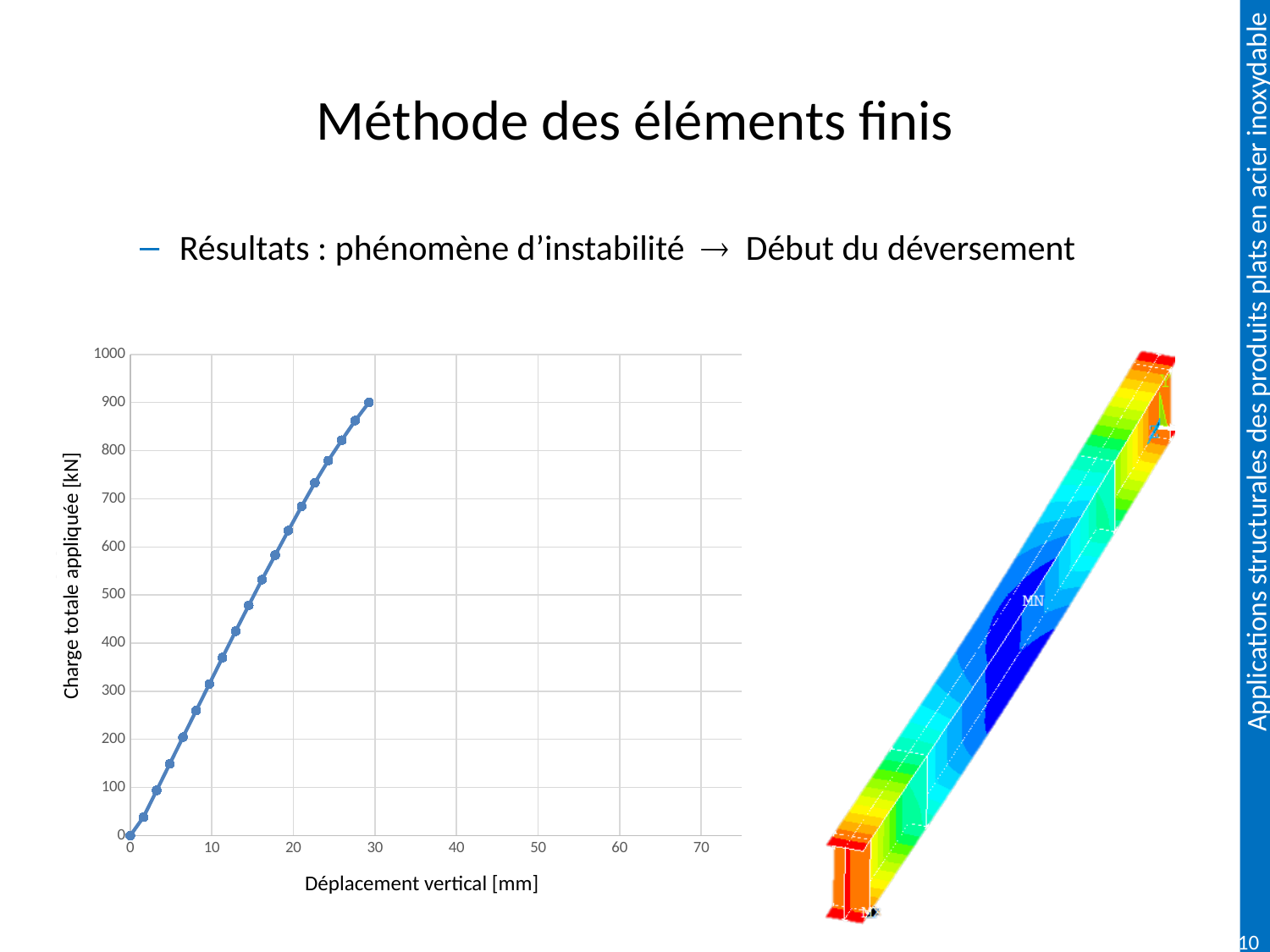
Is the highest applied load reached on the curve greater or less than 800 kN? greater Is the vertical displacement at an applied load of 900 kN greater or less than 20 mm? greater What is the applied load at a vertical displacement of 0 mm? 0 Is the vertical displacement at an applied load of 500 kN greater or less than 10 mm? greater Does the applied load rise or fall as the vertical displacement increases? rises What is the label of the x axis? Déplacement vertical [mm] What kind of chart is shown on the slide? line chart What is the label of the y axis? Charge totale appliquée [kN]